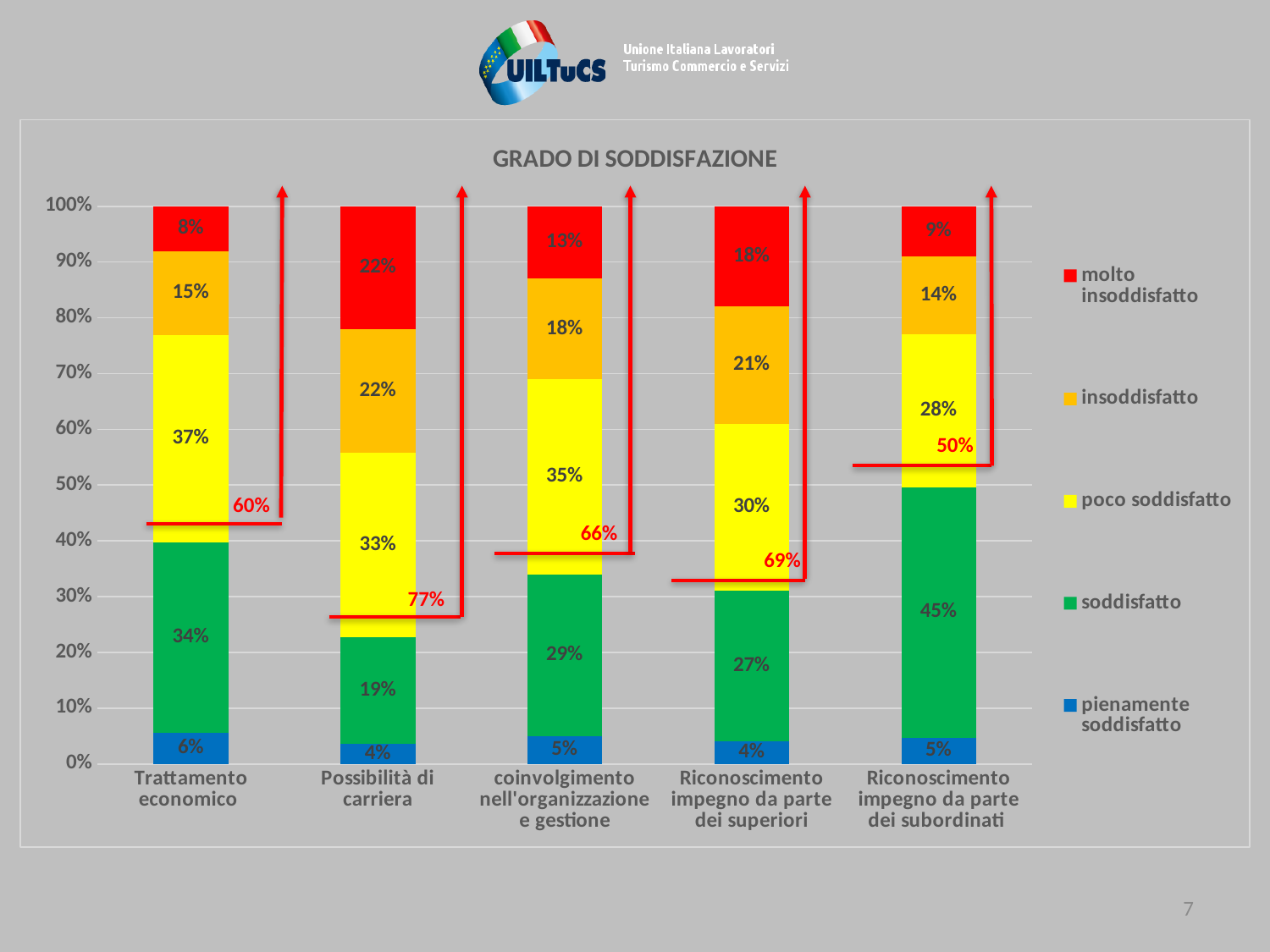
What is the 'soddisfatto' value for 'Riconoscimento impegno da parte dei subordinati'? 45% Which is larger: the 'soddisfatto' value for 'coinvolgimento nell'organizzazione e gestione' or for 'Riconoscimento impegno da parte dei superiori'? coinvolgimento nell'organizzazione e gestione What type of chart is shown on the slide? bar chart How many categories are shown on the x axis of the chart? 5 How many series does the legend list? 5 What is the difference between the 'insoddisfatto' values for 'Possibilità di carriera' and 'Trattamento economico'? 7% Which category has the highest 'soddisfatto' value? Riconoscimento impegno da parte dei subordinati Which category has the lowest 'molto insoddisfatto' value? Trattamento economico What is the 'molto insoddisfatto' value for 'Possibilità di carriera'? 22% What is the 'poco soddisfatto' value for 'Trattamento economico'? 37% What red annotated percentage is shown next to the 'Possibilità di carriera' bar? 77% What is the title of the chart? GRADO DI SODDISFAZIONE